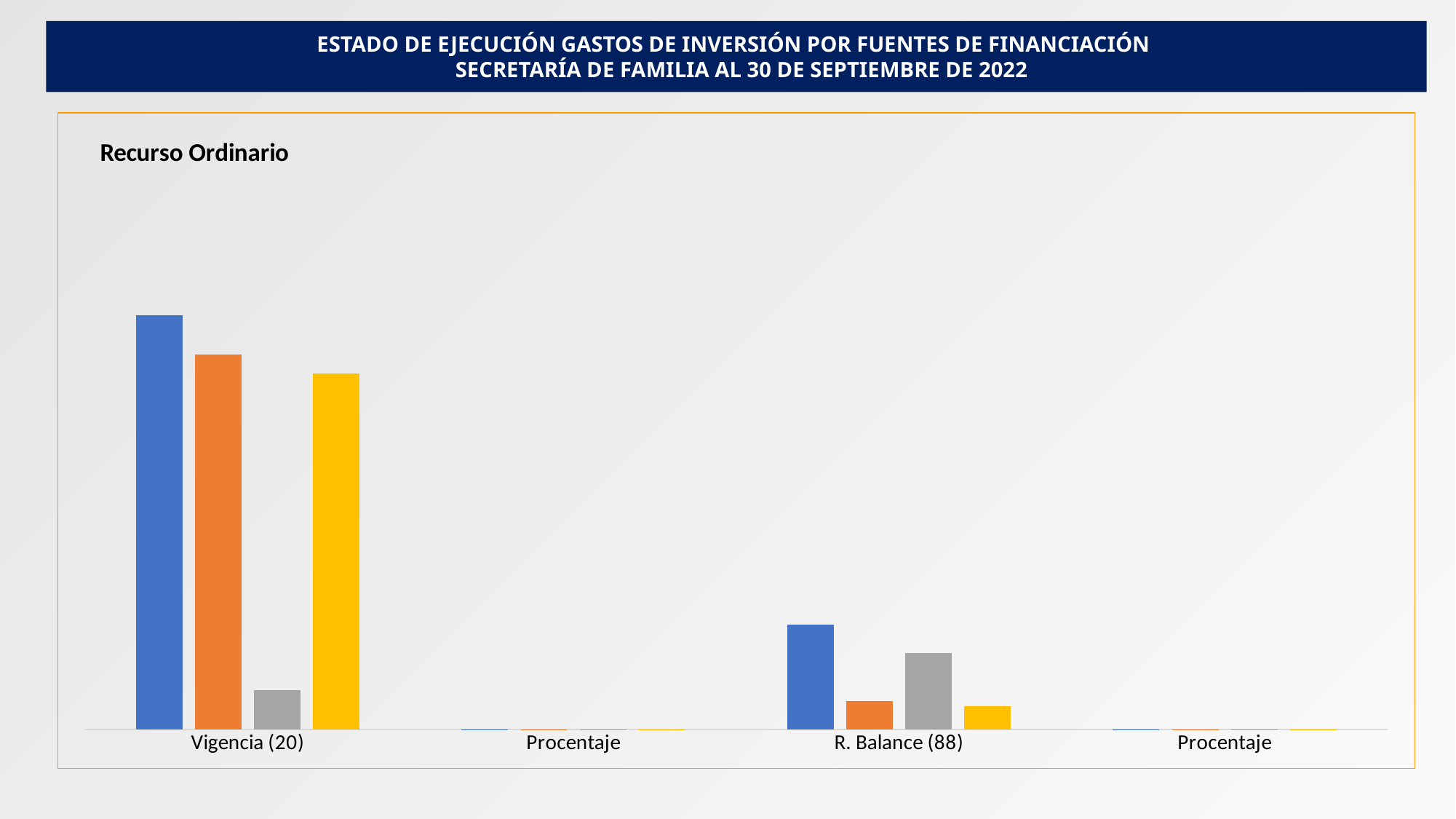
Is the orange bar for Vigencia (20) taller or shorter than the orange bar for R. Balance (88)? Taller What is the title of the chart? Recurso Ordinario Which x-axis label appears twice in the chart? Procentaje What kind of chart is shown on the slide? Bar chart Within the Vigencia (20) category, which coloured bar is the shortest? Gray How many categories are shown on the x axis of the chart? 4 Within the R. Balance (88) category, which coloured bar is the shortest? Yellow Which category has the tallest bar in the chart? Vigencia (20) Which category has the tallest blue bar, Vigencia (20) or R. Balance (88)? Vigencia (20) Within the Vigencia (20) category, which coloured bar is the tallest? Blue Within the R. Balance (88) category, is the gray bar taller or shorter than the yellow bar? Taller How many distinct bar colours are plotted for each category? 4